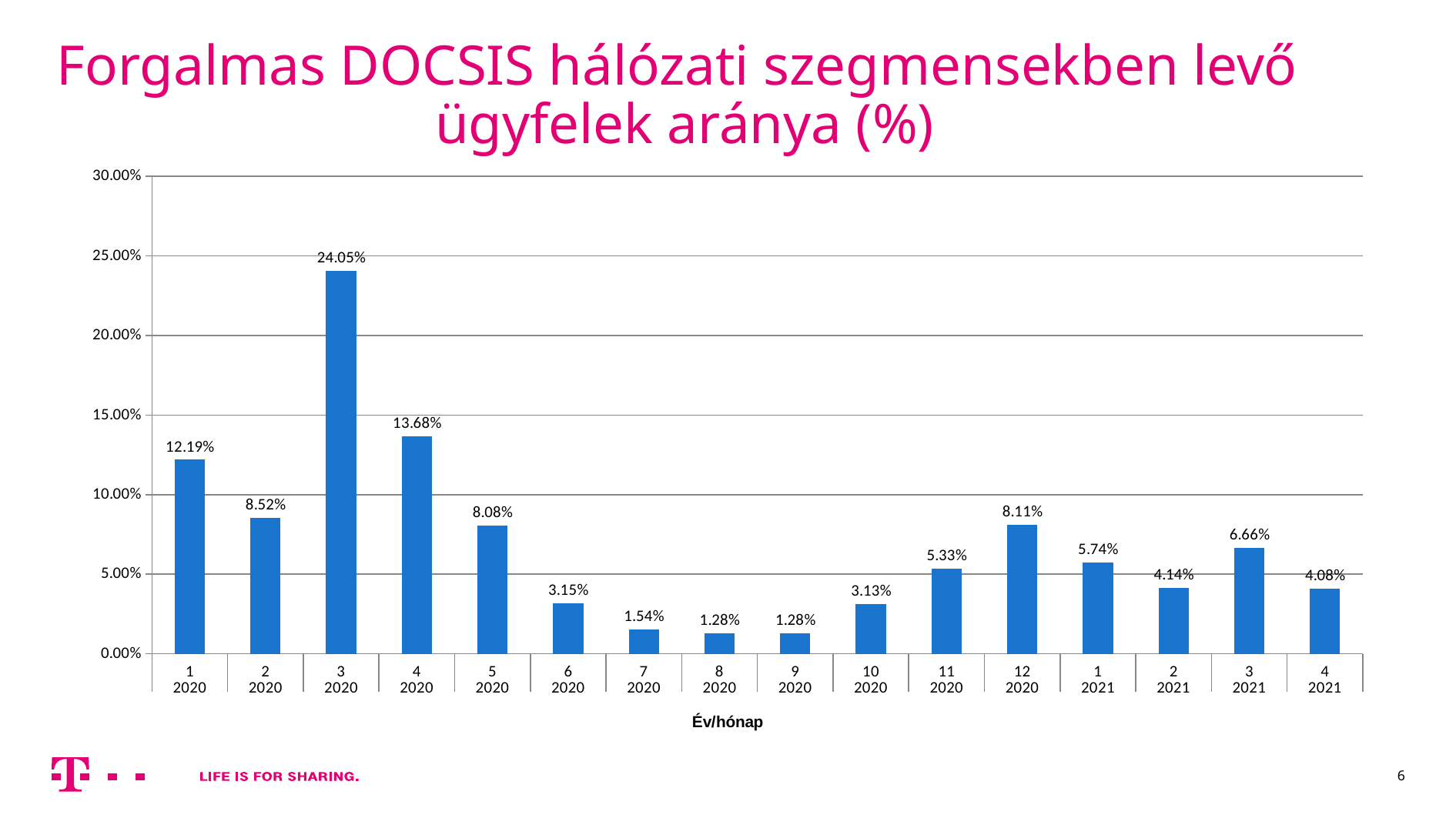
What is the value for month 12 of 2020? 8.11% What is the value for month 4 of 2021? 4.08% What is the lowest value shown on the chart? 1.28% What kind of chart is shown on the slide? bar chart Do the values rise or fall from month 3 of 2020 to month 9 of 2020? fall Which month has the highest value? 3 2020 What is the difference between the values for month 3 of 2020 and month 4 of 2020? 10.37% What is the value for month 3 of 2020? 24.05% Which is larger, the value for month 1 of 2020 or month 4 of 2020? 4 2020 Is the value for month 11 of 2020 greater or less than 10.00%? less What is the label of the x axis? Év/hónap How many months (bars) are shown on the chart? 16